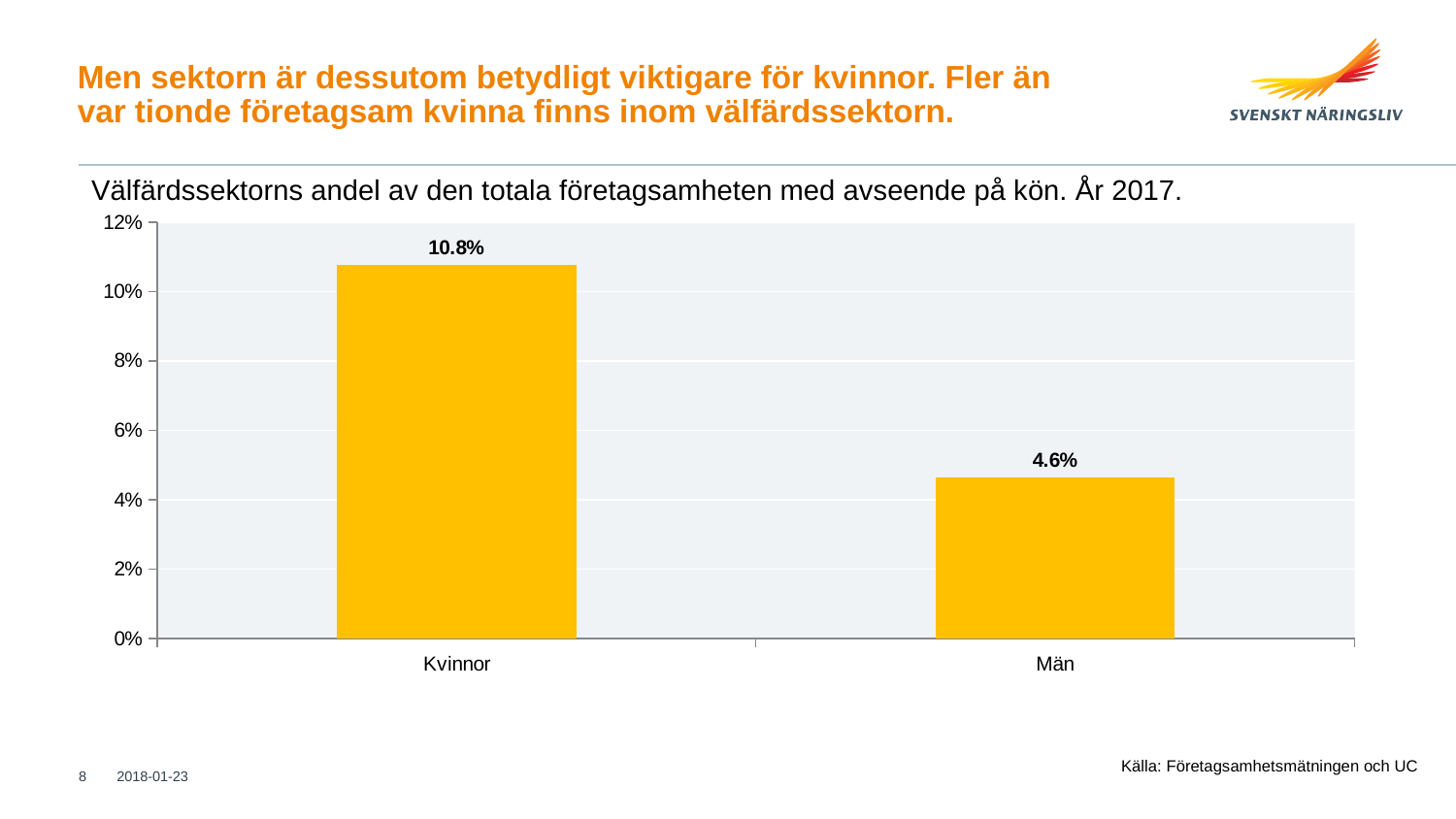
What kind of chart is shown on the slide? bar chart What is the title of the chart? Välfärdssektorns andel av den totala företagsamheten med avseende på kön. År 2017. What colour are the bars in the chart? yellow What is the difference between the values for Kvinnor and Män? 6.2% Which is larger, the value for Kvinnor or the value for Män? Kvinnor How many categories are shown on the x axis? 2 Is the value for Män greater or less than 6%? less What is the value for Kvinnor? 10.8% Which category has the lowest value? Män Is the value for Kvinnor greater or less than 10%? greater Which category has the highest value? Kvinnor What is the value for Män? 4.6%